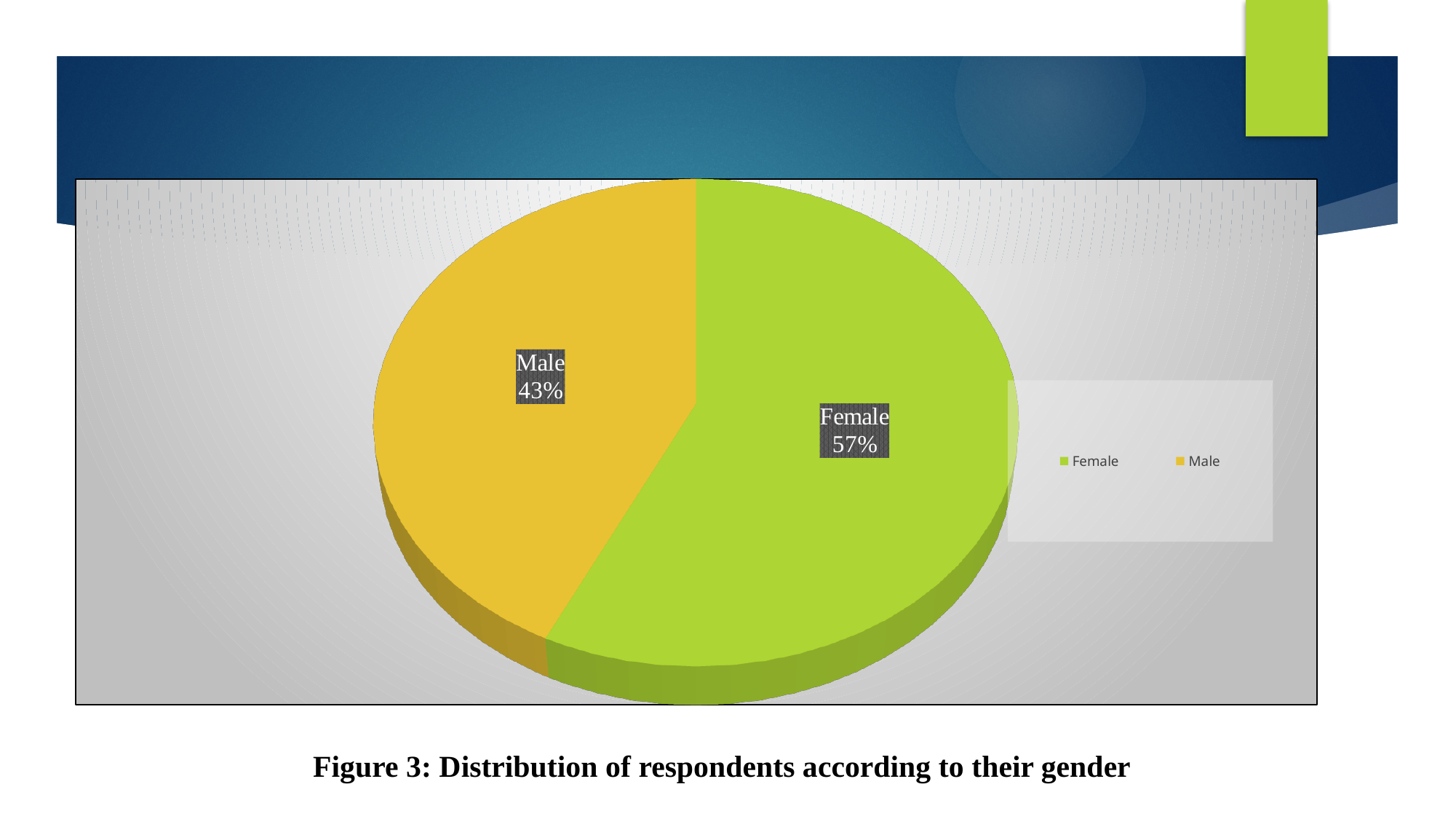
What is the caption of the figure shown on the slide? Figure 3: Distribution of respondents according to their gender Which gender category has the largest share of respondents? Female What percentage of respondents are Male? 43% What share of the pie does the Female slice represent? 57% What colour is the Male slice of the pie chart? Yellow Which gender category has the smallest share of respondents? Male What is the difference in percentage points between the Female and Male shares? 14 Which is larger, the Female share or the Male share? Female What percentage of respondents are Female? 57% How many categories does the pie chart show? 2 What kind of chart is shown on the slide? Pie chart